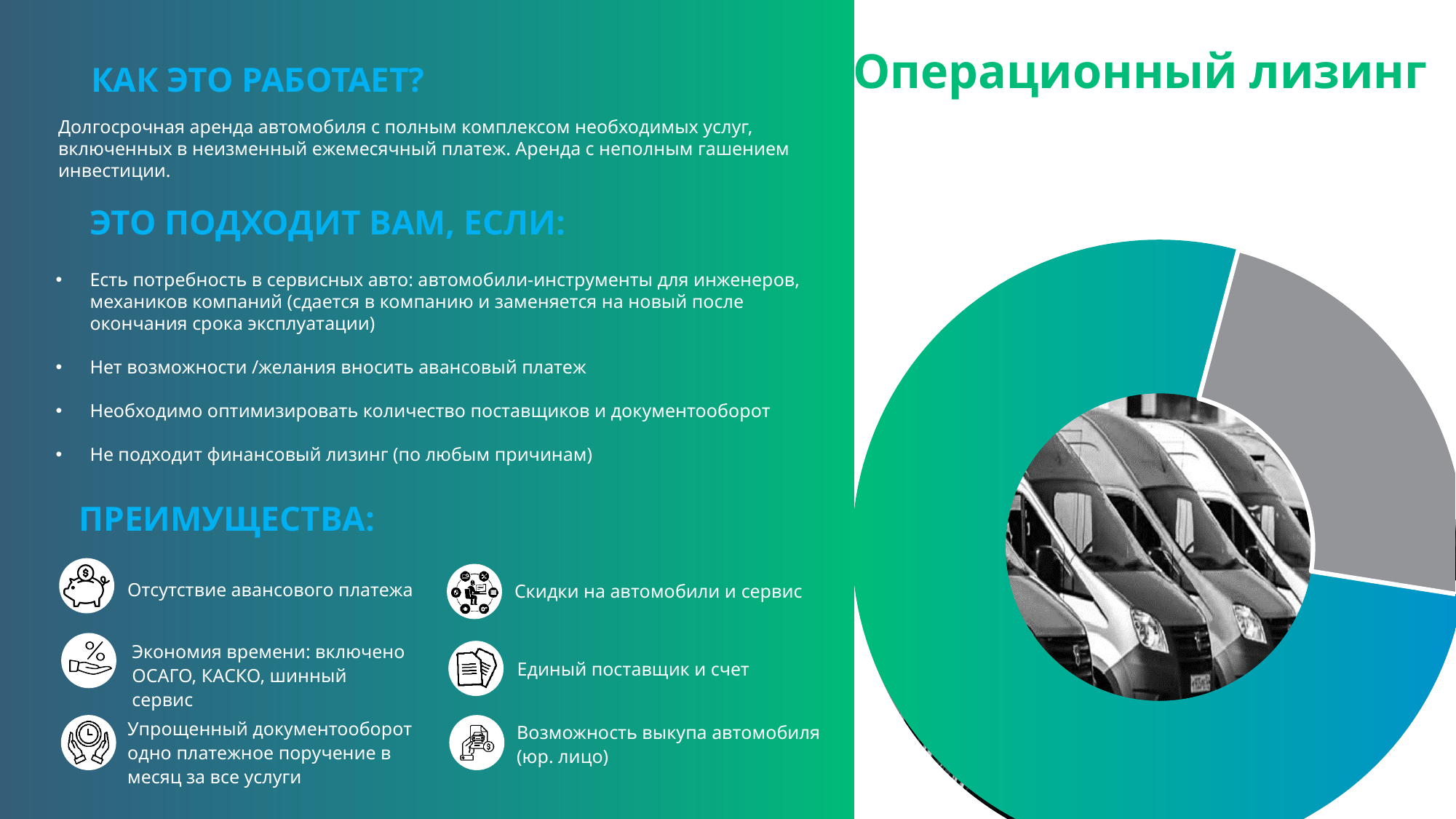
What kind of chart is shown on the right side of the slide? Doughnut (pie) chart What is shown in the centre of the doughnut chart? A photo of vans Does the green/teal slice of the doughnut chart take up more or less than half of the chart? More How many slices does the doughnut chart on the right side of the slide have? 2 Which slice of the doughnut chart is the largest? The large teal-to-blue gradient slice (the non-gray one)